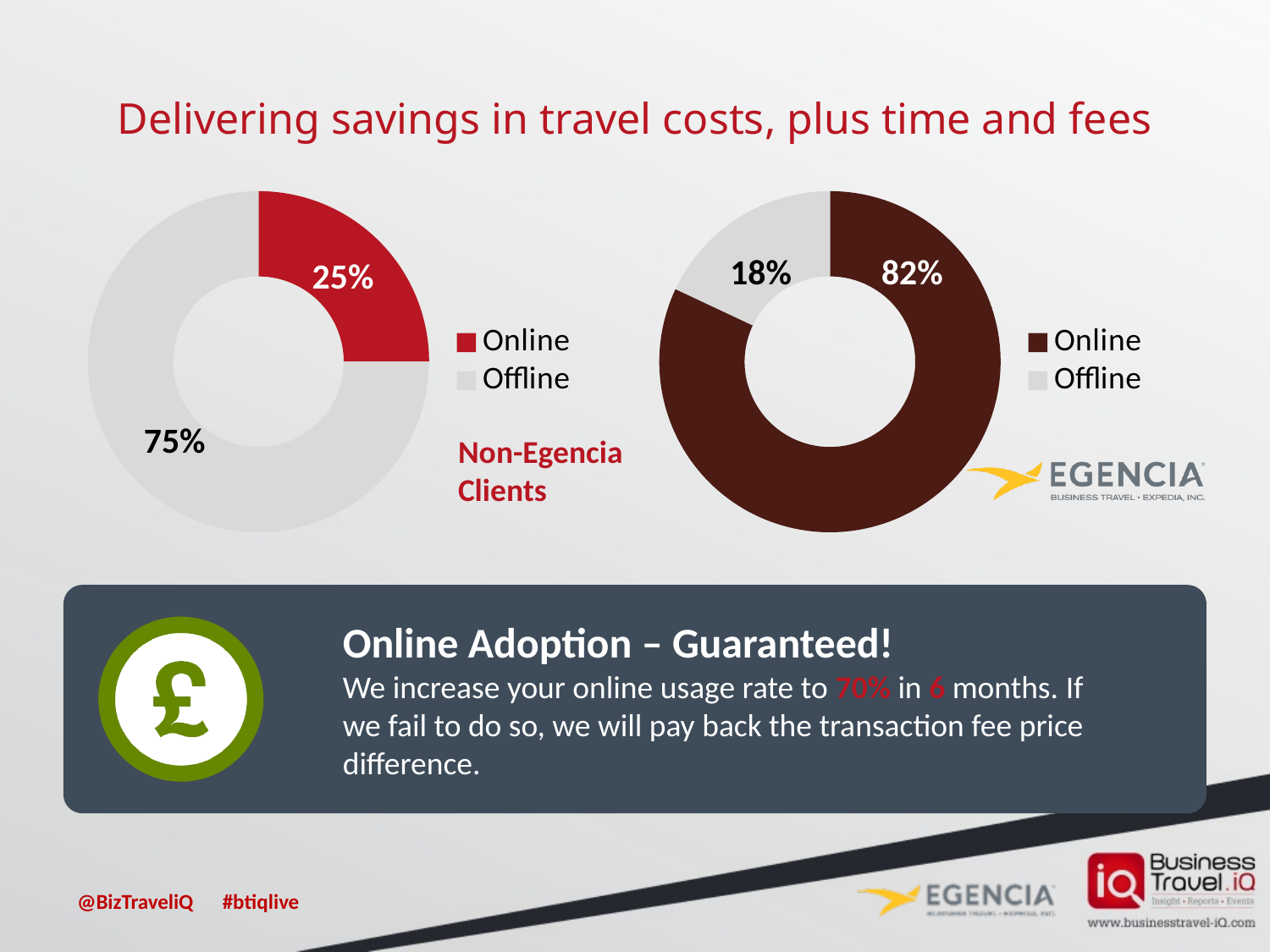
How many entries does the legend of the left doughnut chart list? 2 In the right doughnut chart (Egencia), what percentage is Online? 82% In the left doughnut chart (Non-Egencia Clients), which slice is larger, Online or Offline? Offline In the right doughnut chart (Egencia), which slice is the smallest? Offline In the right doughnut chart (Egencia), what percentage is Offline? 18% In the right doughnut chart (Egencia), what is the difference between the Online and Offline percentages? 64% What type of chart is used on the left side of the slide? Doughnut (pie) chart In the left doughnut chart (Non-Egencia Clients), what percentage is Online? 25% In the right doughnut chart (Egencia), which slice is the largest? Online In the left doughnut chart (Non-Egencia Clients), what percentage is Offline? 75% In the left doughnut chart (Non-Egencia Clients), what is the difference between the Offline and Online percentages? 50% What colour is the Online slice in the left doughnut chart (Non-Egencia Clients)? Red